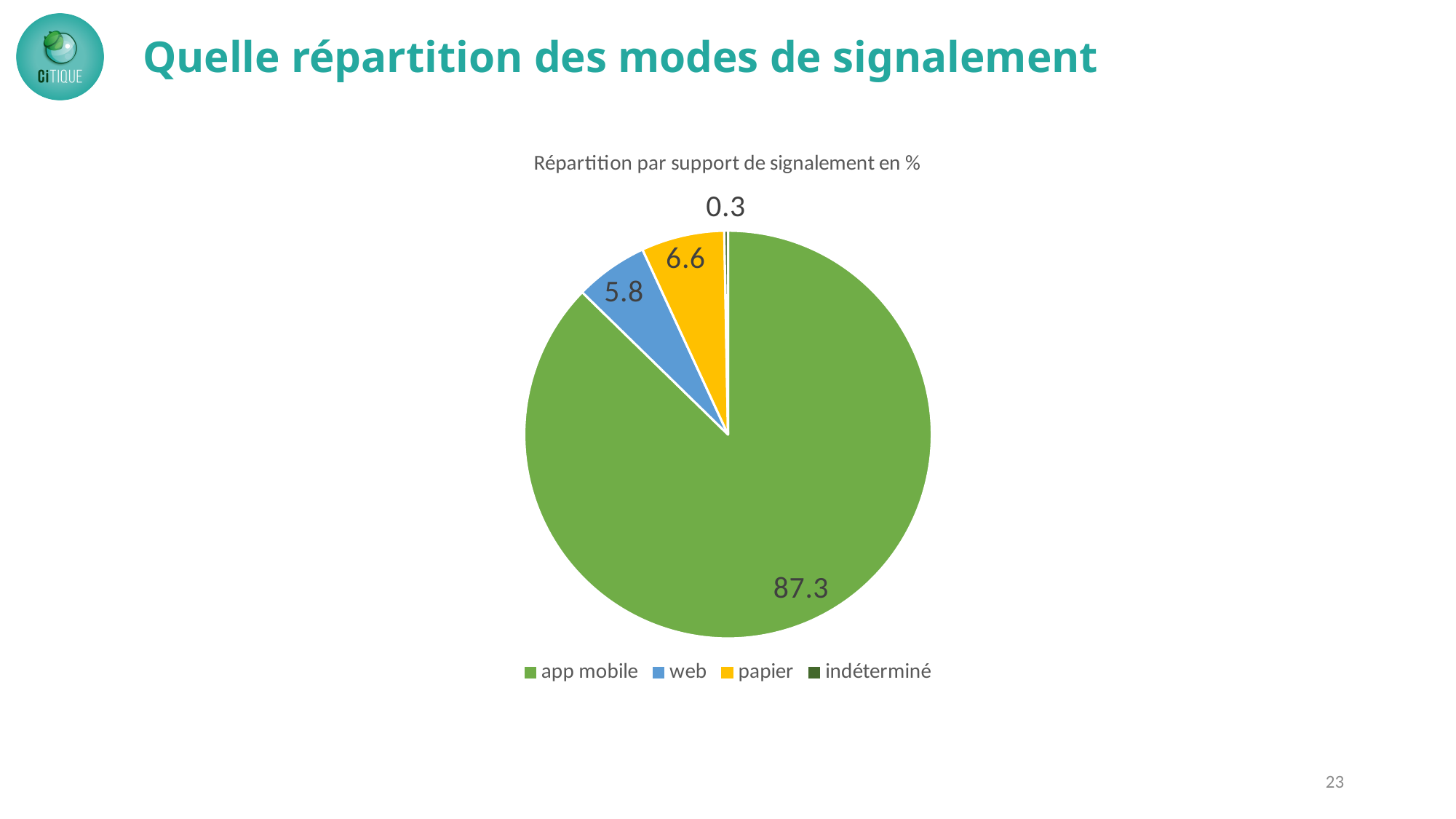
What is the title of the chart? Répartition par support de signalement en % What type of chart is shown on the slide? pie chart What is the value for app mobile? 87.3 What is the value for web? 5.8 What is the value for indéterminé? 0.3 What colour is the slice for papier? yellow Which category has the smallest share of the pie? indéterminé Which is larger, papier or web? papier What is the value for papier? 6.6 How many categories does the legend list? 4 Which category has the largest share of the pie? app mobile What is the difference between the values for papier and web? 0.8